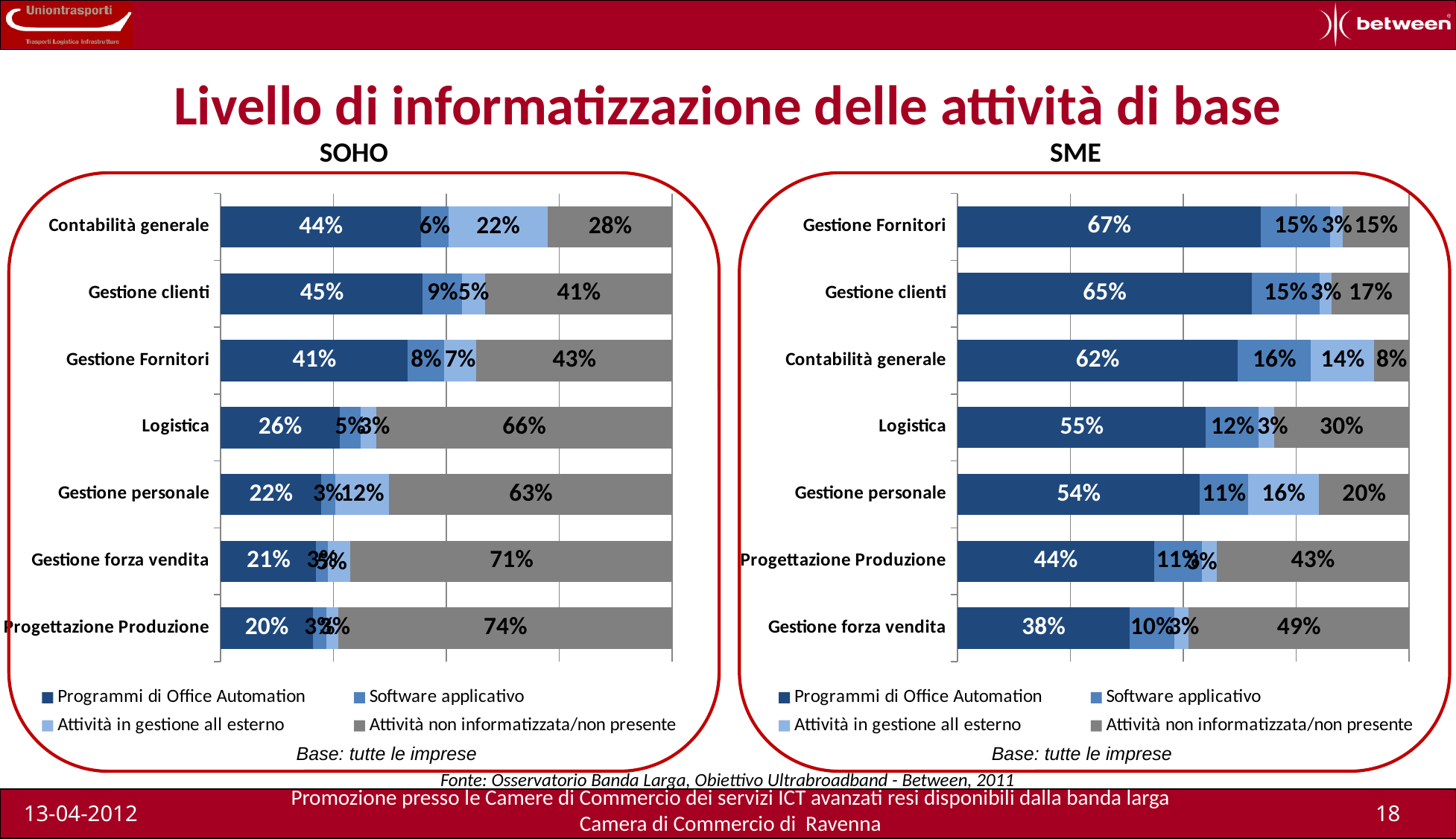
In the SOHO chart, what is the value for Programmi di Office Automation for Contabilità generale? 44% How many categories are shown in the SME chart? 7 In the SME chart, what is the value for Attività in gestione all esterno for Gestione personale? 16% In the SME chart, what is the value for Attività non informatizzata/non presente for Logistica? 30% In the SOHO chart, what is the value for Attività non informatizzata/non presente for Logistica? 66% In the SOHO chart, which is larger for Gestione personale: Attività in gestione all esterno or Software applicativo? Attività in gestione all esterno In the SME chart, which category has the lowest value for Programmi di Office Automation? Gestione forza vendita In the SOHO chart, which category has the highest value for Attività non informatizzata/non presente? Progettazione Produzione In the SME chart, what is the value for Programmi di Office Automation for Gestione Fornitori? 67% How many series does the legend of the SOHO chart list? 4 In the SME chart, what is the difference between the Programmi di Office Automation values for Gestione Fornitori and Gestione forza vendita? 29% What kind of chart is the SOHO chart? Stacked bar chart